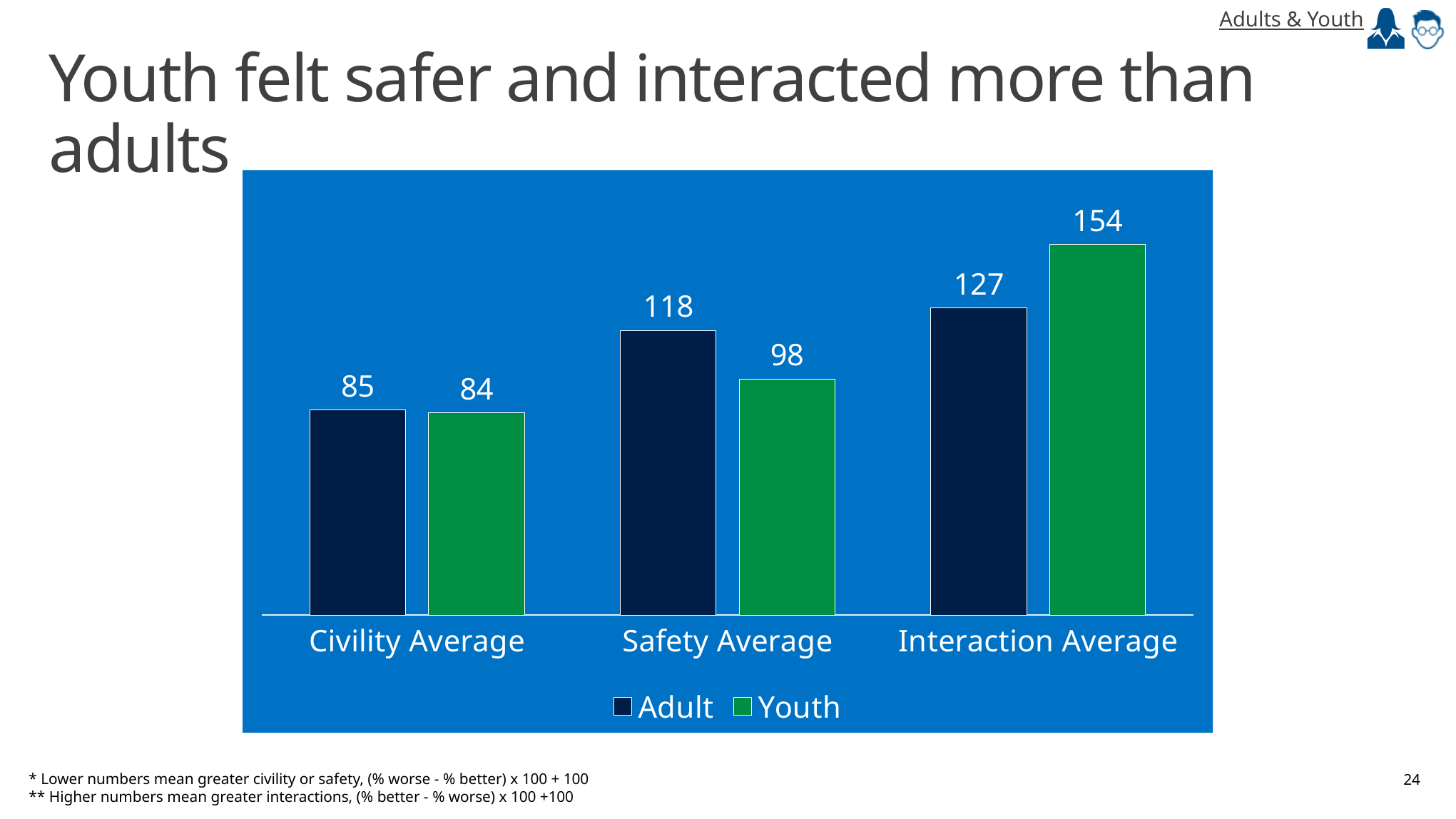
Which category has the highest Youth value? Interaction Average What is the Adult value for Civility Average? 85 What kind of chart is shown on the slide? Bar chart What is the Youth value for Interaction Average? 154 What is the Youth value for Safety Average? 98 How many categories are shown on the x axis? 3 What is the difference between the Youth and Adult values for Interaction Average? 27 For Safety Average, which is larger, the Adult value or the Youth value? Adult What is the Adult value for Interaction Average? 127 What is the difference between the Adult and Youth values for Safety Average? 20 How many series does the legend list? 2 Which category has the lowest Adult value? Civility Average